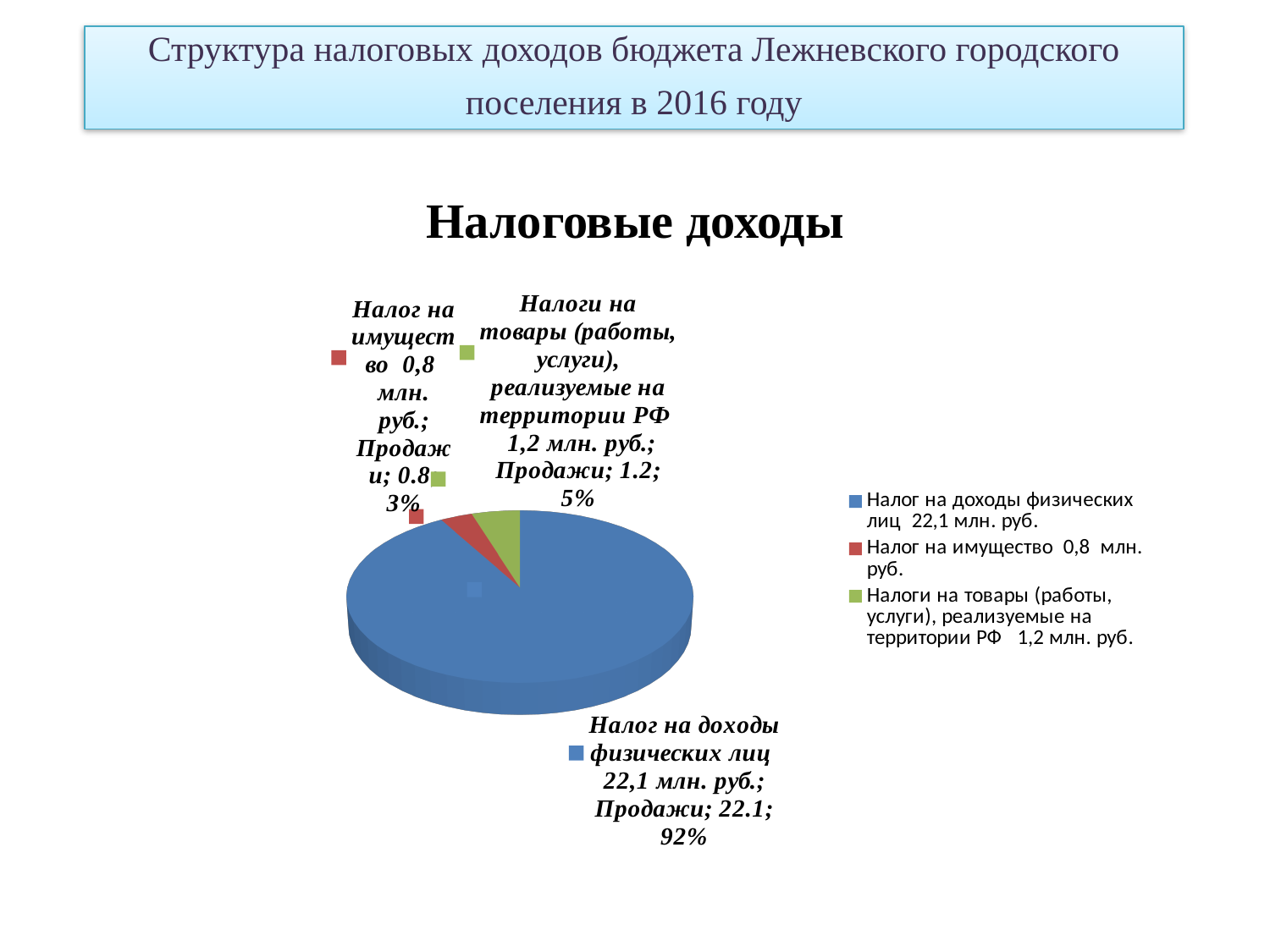
Which category has the largest slice of the pie? Налог на доходы физических лиц What share of the pie does "Налог на доходы физических лиц" take? 92% What is the title of the chart? Налоговые доходы Which is larger: the slice for "Налоги на товары (работы, услуги), реализуемые на территории РФ" or the slice for "Налог на имущество"? Налоги на товары (работы, услуги), реализуемые на территории РФ What share of the pie does "Налоги на товары (работы, услуги), реализуемые на территории РФ" take? 5% How many slices does the pie chart have? 3 What kind of chart is shown on the slide? pie chart What value is shown for "Налог на имущество"? 0.8 What value is shown for "Налог на доходы физических лиц"? 22.1 How many entries does the chart legend list? 3 Which category has the smallest slice of the pie? Налог на имущество What share of the pie does "Налог на имущество" take? 3%